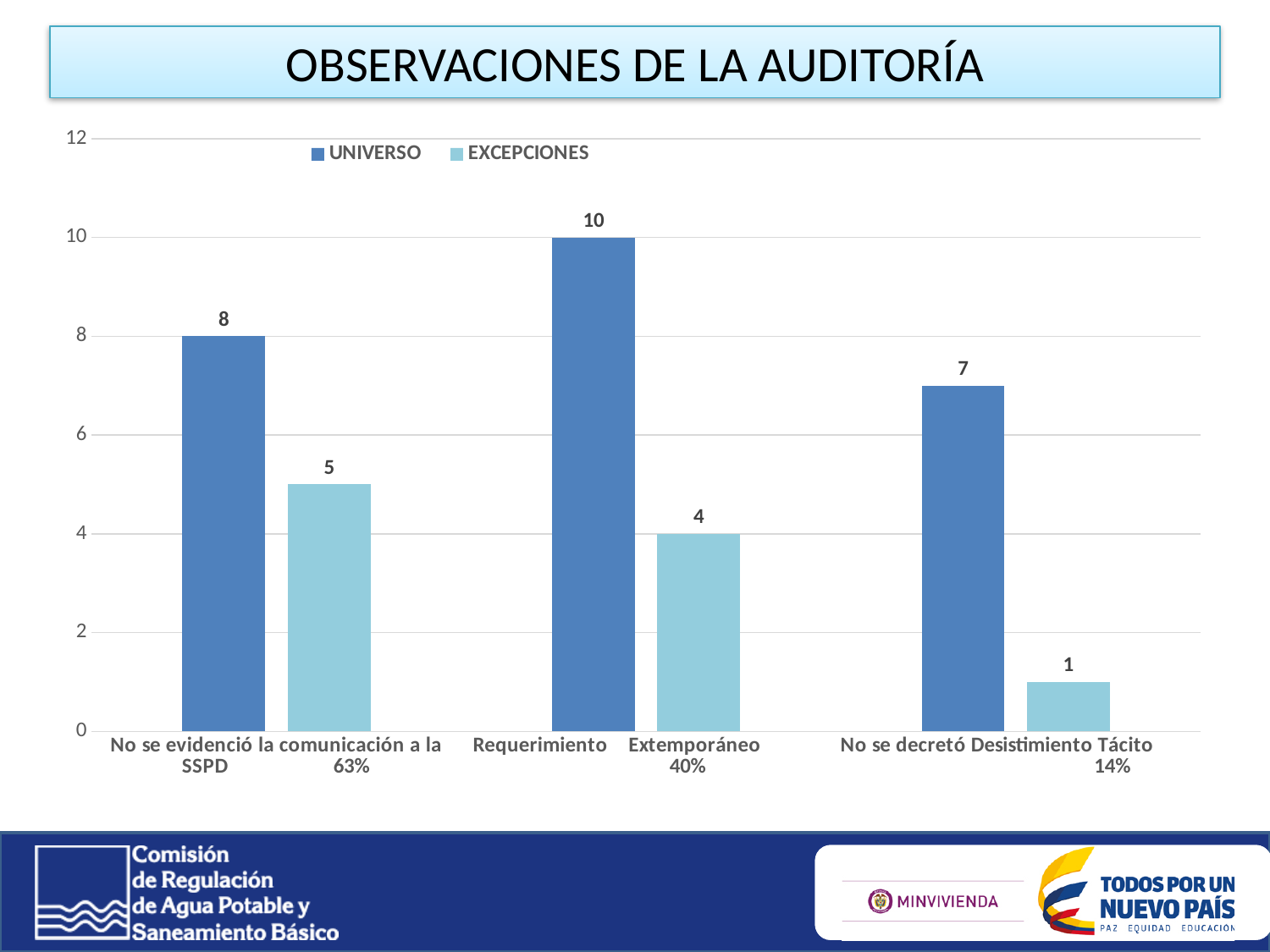
What is the UNIVERSO value for No se decretó Desistimiento Tácito? 7 What percentage is shown under the category No se decretó Desistimiento Tácito? 14% What is the UNIVERSO value for Requerimiento Extemporáneo? 10 How many series does the legend list? 2 Which category has the lowest EXCEPCIONES value? No se decretó Desistimiento Tácito How many categories are shown on the x axis? 3 Which category has the highest UNIVERSO value? Requerimiento Extemporáneo What kind of chart is shown on the slide? Bar chart What is the EXCEPCIONES value for No se decretó Desistimiento Tácito? 1 What is the EXCEPCIONES value for No se evidenció la comunicación a la SSPD? 5 What is the difference between the UNIVERSO and EXCEPCIONES values for Requerimiento Extemporáneo? 6 Which is larger: the EXCEPCIONES value for No se evidenció la comunicación a la SSPD or the EXCEPCIONES value for Requerimiento Extemporáneo? No se evidenció la comunicación a la SSPD